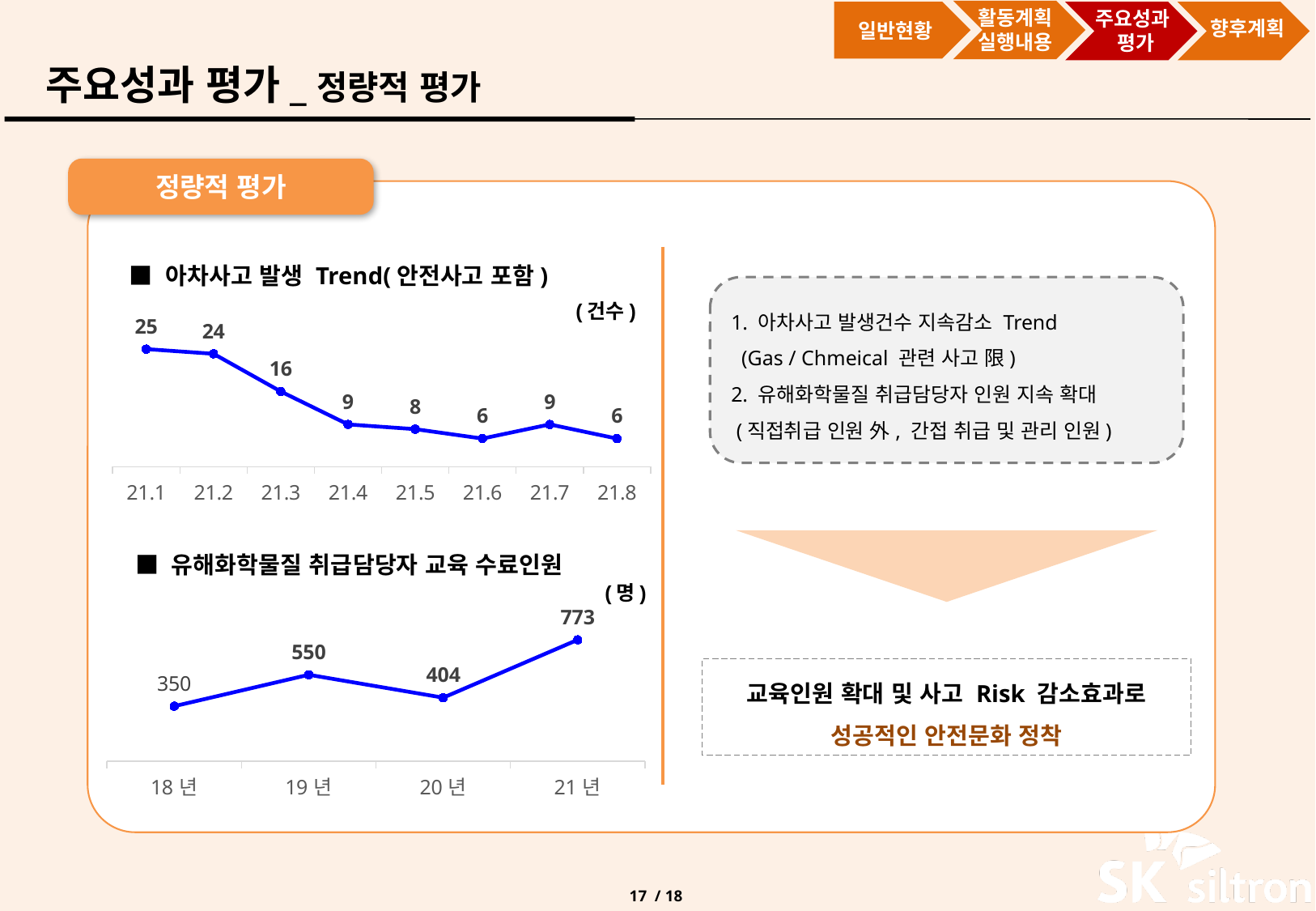
In the top chart (아차사고 발생 Trend), which period has the highest value? 21.1 In the bottom chart (유해화학물질 취급담당자 교육 수료인원), what is the value for 19 년? 550 In the bottom chart (유해화학물질 취급담당자 교육 수료인원), what is the difference between the values for 21 년 and 20 년? 369 In the top chart (아차사고 발생 Trend), what is the value for 21.7? 9 What unit is shown in the top-right corner of the bottom chart (유해화학물질 취급담당자 교육 수료인원)? (명) In the top chart (아차사고 발생 Trend), do the values generally rise or fall from 21.1 to 21.8? fall In the bottom chart (유해화학물질 취급담당자 교육 수료인원), which year has the lowest value? 18 년 In the top chart (아차사고 발생 Trend), how many data points are plotted? 8 What type of chart is the bottom chart (유해화학물질 취급담당자 교육 수료인원)? line chart In the bottom chart (유해화학물질 취급담당자 교육 수료인원), which is larger, the value for 20 년 or 19 년? 19 년 In the top chart (아차사고 발생 Trend), what is the value for 21.3? 16 In the top chart (아차사고 발생 Trend), what is the difference between the values for 21.1 and 21.8? 19